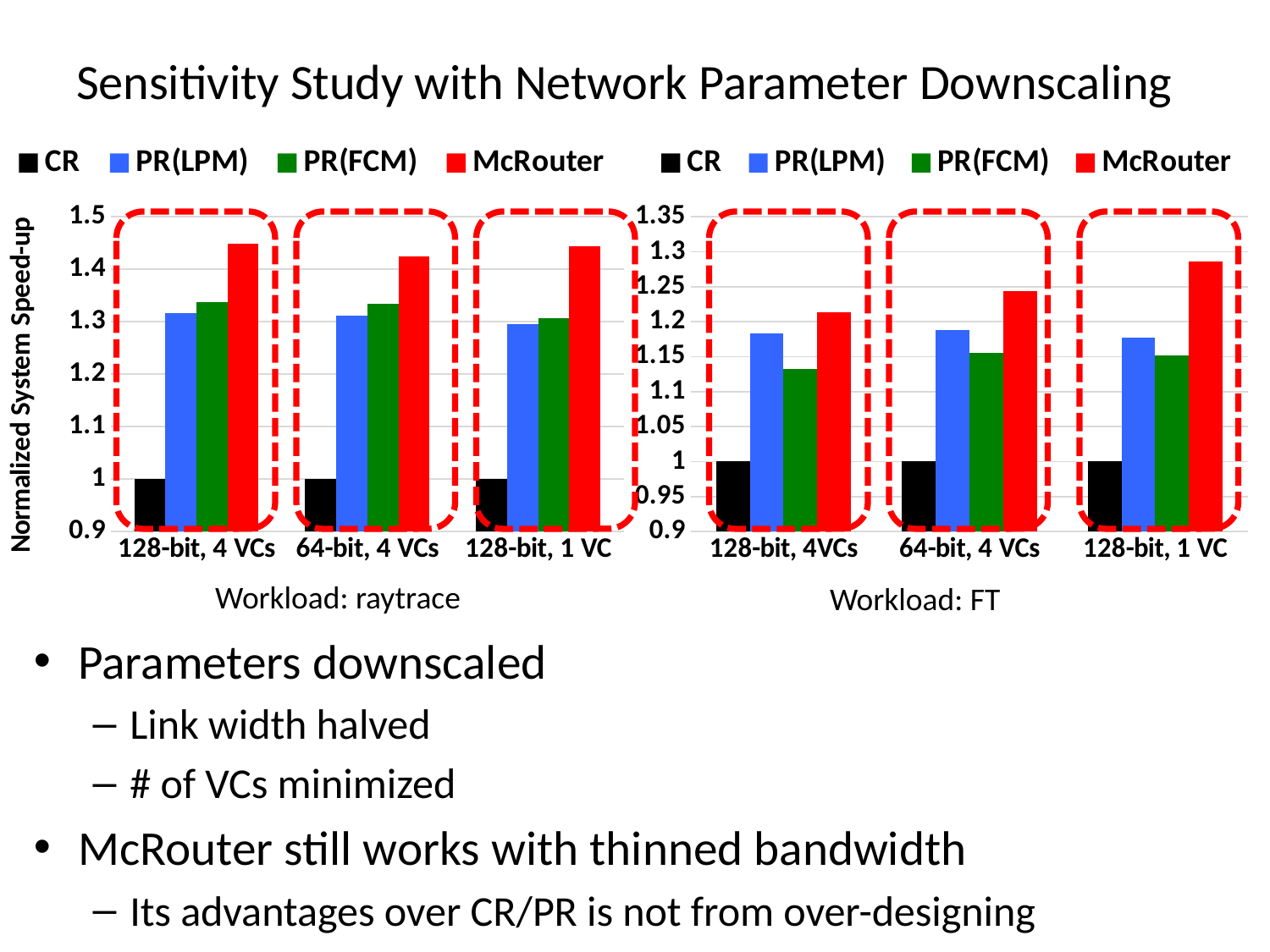
How many categories are shown on the x axis of the Workload: raytrace chart? 3 In the Workload: raytrace chart, is the value for McRouter at 128-bit, 4 VCs greater or less than 1.4? greater How many series does the legend of the Workload: FT chart list? 4 In the Workload: FT chart, what is the value for CR at 64-bit, 4 VCs? 1 In the Workload: FT chart, which series has the lowest value at 128-bit, 4VCs? CR In the Workload: raytrace chart, which series has the highest value at 64-bit, 4 VCs? McRouter In the Workload: FT chart, is the value for McRouter at 128-bit, 1 VC greater or less than 1.25? greater In the Workload: FT chart, is the value for PR(FCM) at 128-bit, 4VCs greater or less than 1.15? less In the Workload: raytrace chart, what is the value for CR at 128-bit, 4 VCs? 1 In the Workload: FT chart, which is larger at 128-bit, 4VCs: PR(LPM) or PR(FCM)? PR(LPM) What type of chart is the Workload: raytrace chart? bar chart